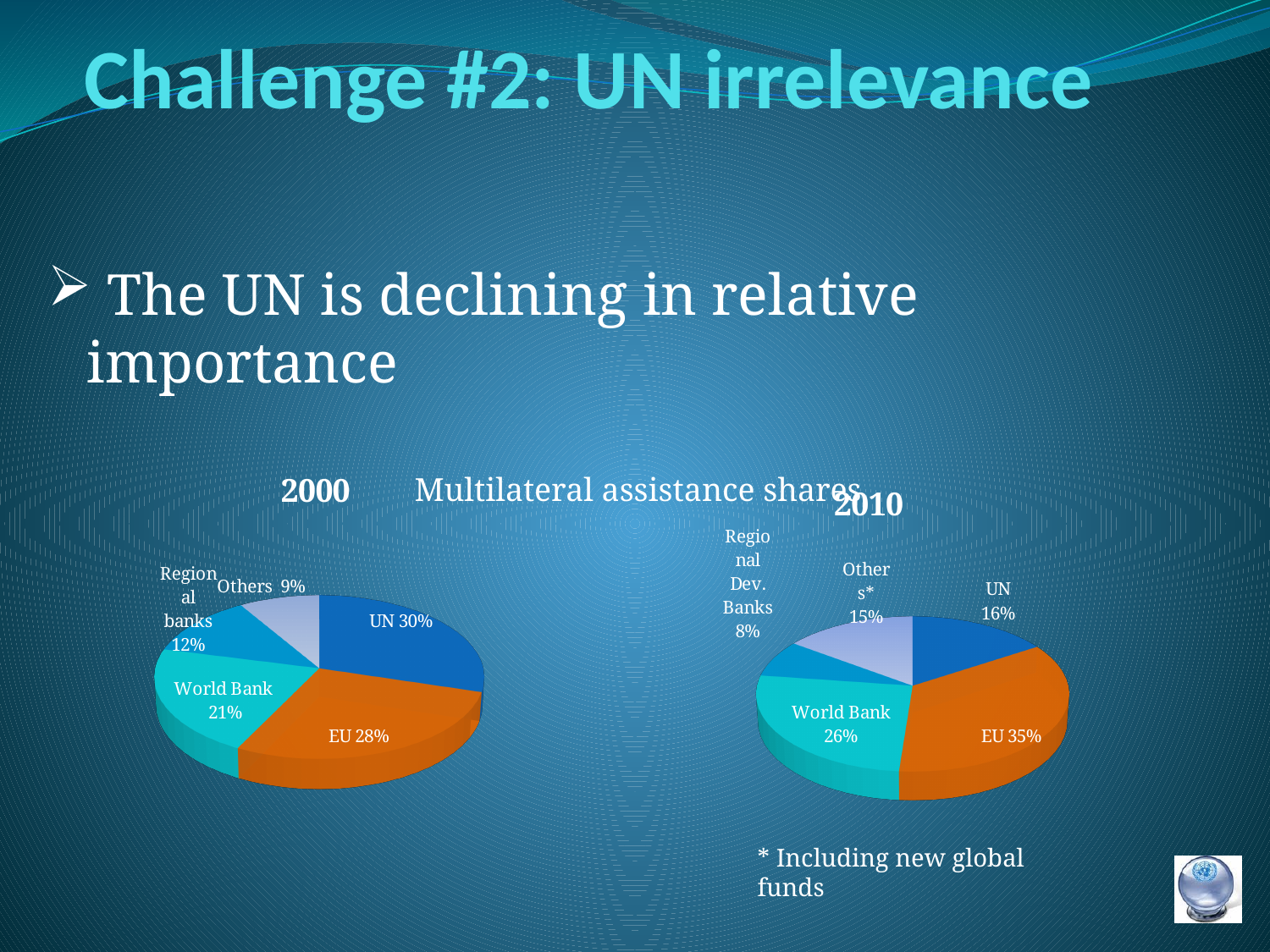
In the 2000 pie chart, which category has the largest share? UN In the 2000 pie chart, what share does the UN have? 30% In the 2010 pie chart, what share does the UN have? 16% In the 2000 pie chart, which category has the smallest share? Others In the 2000 pie chart, what share does the World Bank have? 21% In the 2010 pie chart, what share does the EU have? 35% In the 2010 pie chart, which category has the smallest share? Regional Dev. Banks By how many percentage points did the UN share fall from the 2000 pie chart to the 2010 pie chart? 14 In the 2010 pie chart, what is the difference between the EU share and the World Bank share? 9% How many slices does the 2000 pie chart have? 5 In the 2010 pie chart, which is larger, the World Bank share or the Others* share? World Bank What type of chart is used to show the multilateral assistance shares? Pie chart